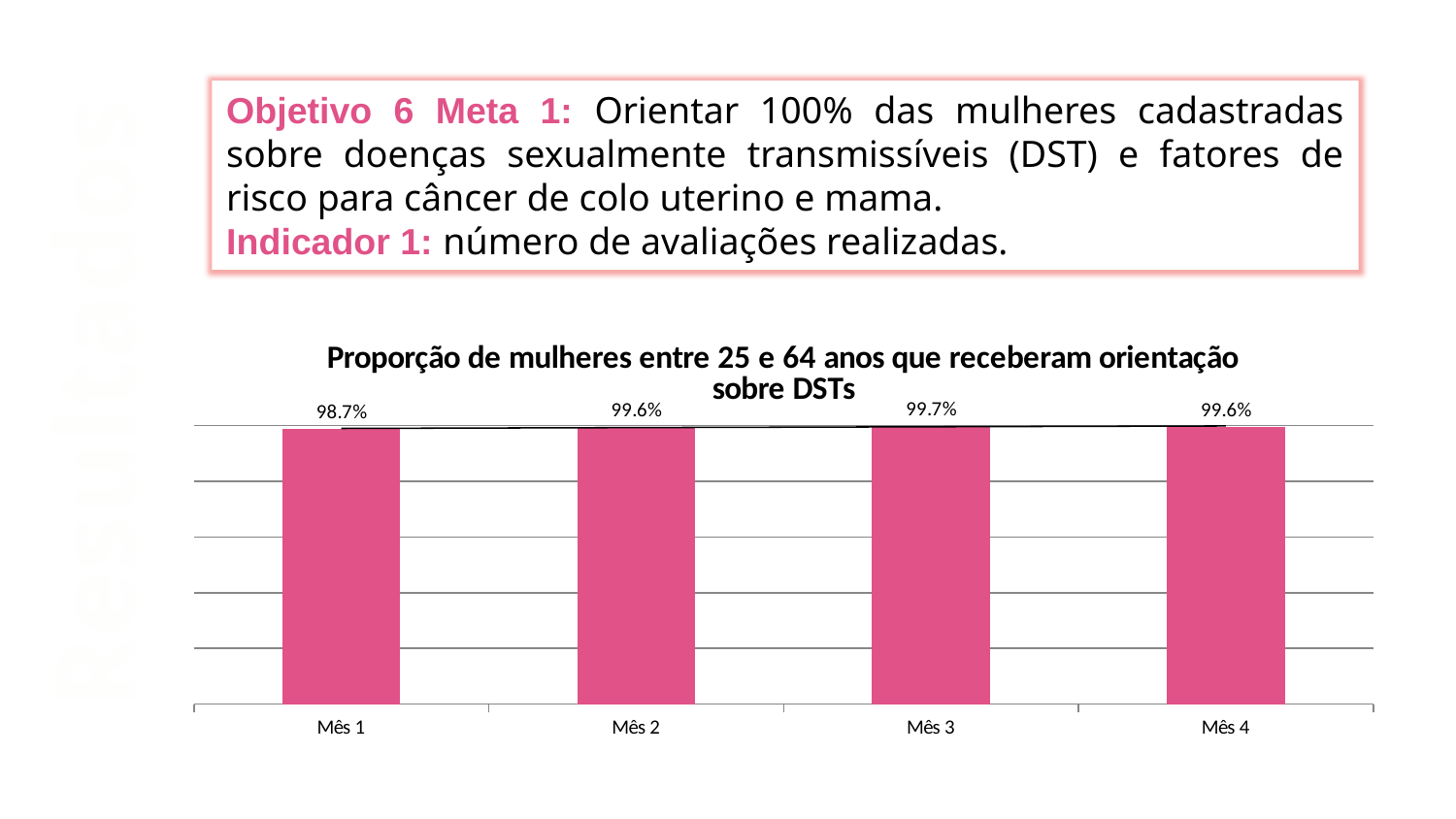
Does the value rise or fall from Mês 1 to Mês 2? Rise How many months are shown on the x axis? 4 What is the title of the chart? Proporção de mulheres entre 25 e 64 anos que receberam orientação sobre DSTs What is the value for Mês 3? 99.7% What is the value for Mês 1? 98.7% What is the value for Mês 4? 99.6% What is the value for Mês 2? 99.6% Which is larger, the value for Mês 1 or the value for Mês 2? Mês 2 Which month has the highest value? Mês 3 Which month has the lowest value? Mês 1 What is the difference between the values for Mês 3 and Mês 1? 1.0 percentage points What kind of chart is shown on the slide? Bar chart